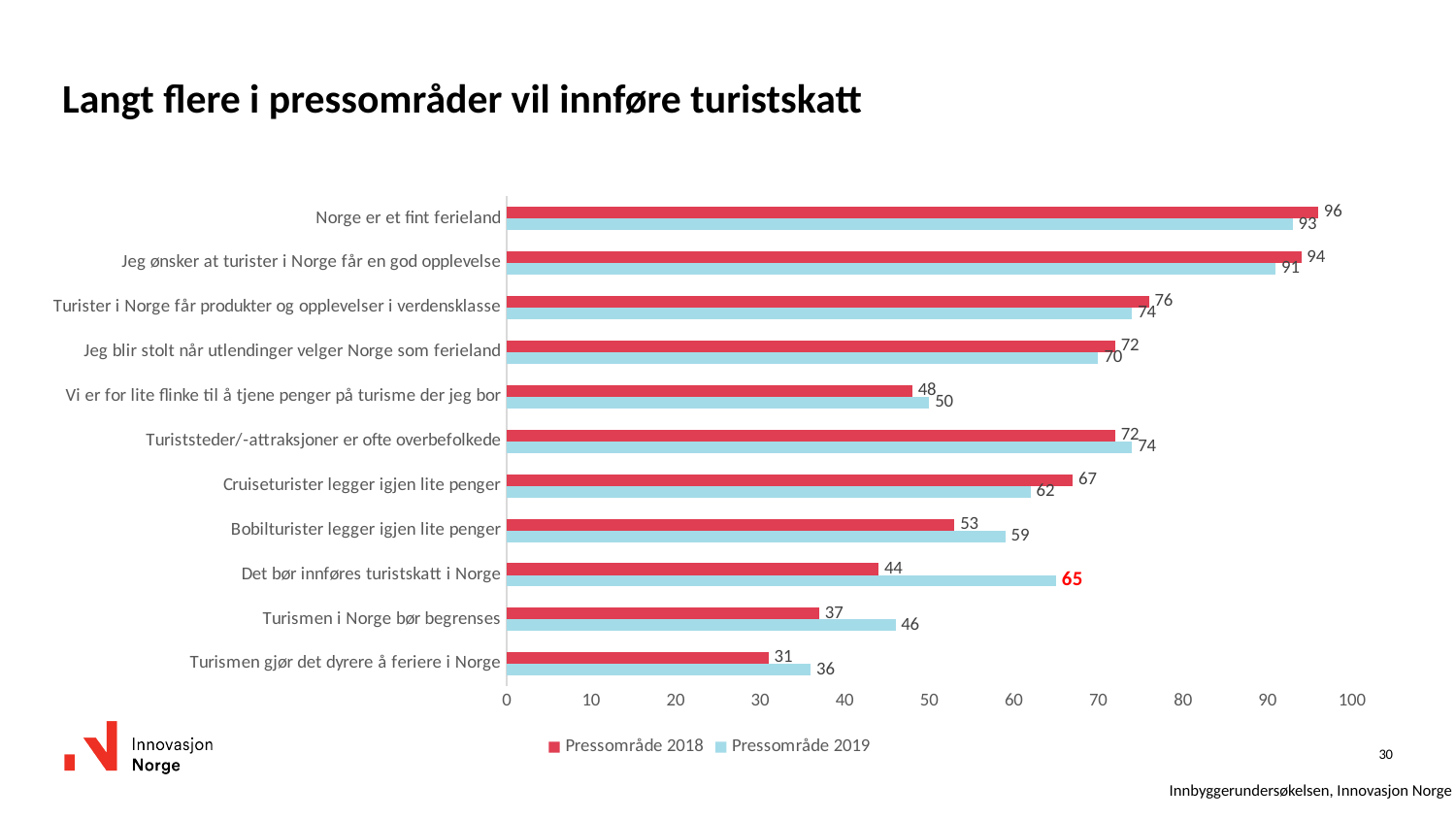
What is the title of the slide? Langt flere i pressområder vil innføre turistskatt How many categories are shown on the chart? 11 How many series does the legend list? 2 For "Bobilturister legger igjen lite penger", which series has the larger value, Pressområde 2018 or Pressområde 2019? Pressområde 2019 Is the Pressområde 2018 value for "Turismen i Norge bør begrenses" greater or less than 40? less What is the value for "Norge er et fint ferieland" in the Pressområde 2018 series? 96 What is the value for "Cruiseturister legger igjen lite penger" in the Pressområde 2019 series? 62 What is the difference between the Pressområde 2019 and Pressområde 2018 values for "Det bør innføres turistskatt i Norge"? 21 Which category has the lowest value in the Pressområde 2018 series? Turismen gjør det dyrere å feriere i Norge What is the value for "Det bør innføres turistskatt i Norge" in the Pressområde 2019 series? 65 What kind of chart is shown on the slide? bar chart Which category has the highest value in the Pressområde 2019 series? Norge er et fint ferieland